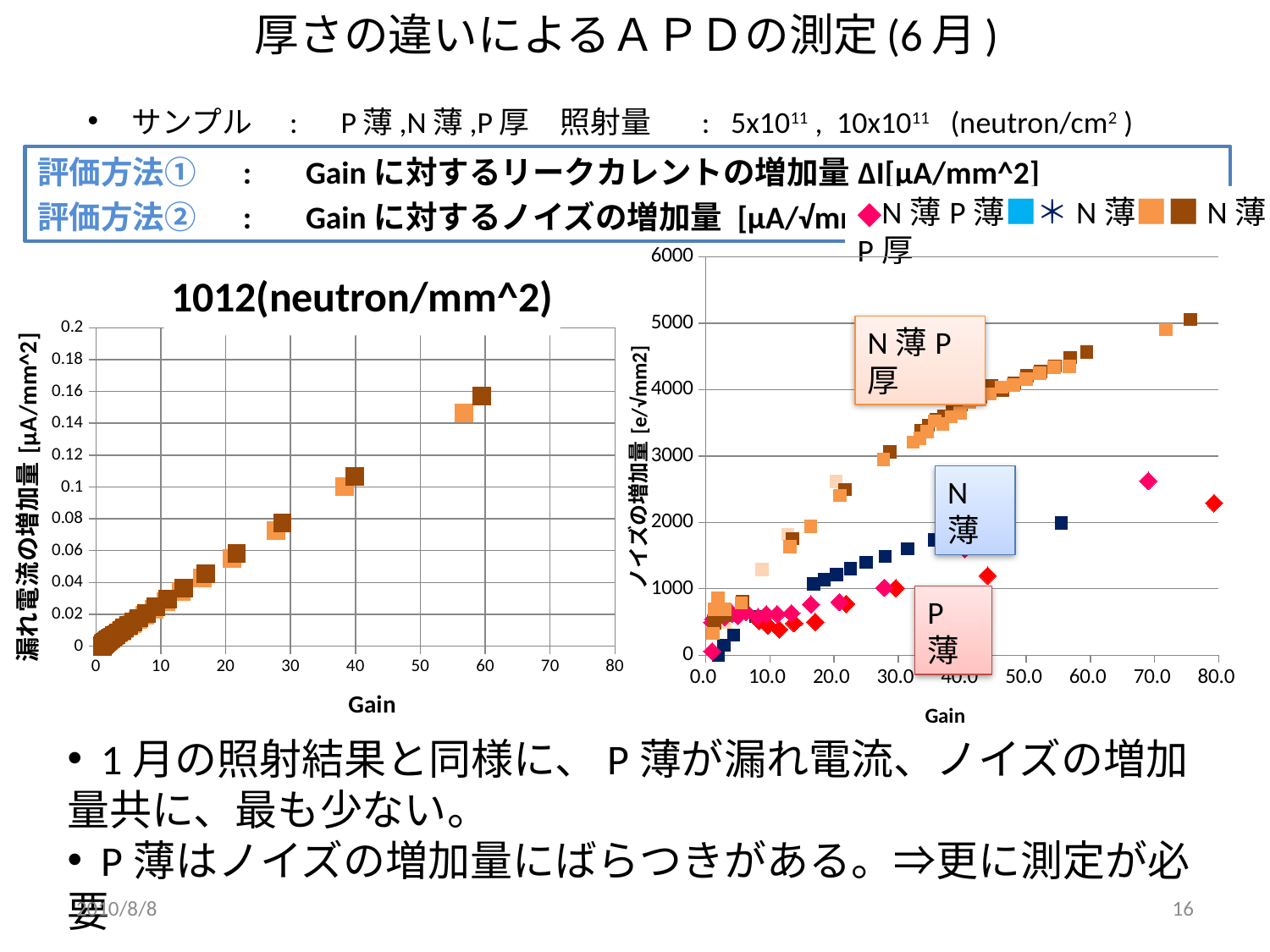
What kind of chart is the left chart titled 1012(neutron/mm^2)? scatter chart What kind of chart is the right chart showing ノイズの増加量 against Gain? scatter chart In the right chart, is the value of the N薄P薄 (pink diamond) series at a Gain of about 80 greater or less than 3000? less In the left chart titled 1012(neutron/mm^2), do the plotted values rise or fall as Gain increases? rise In the right chart, what is the label of the y axis? ノイズの増加量 [e/√mm2] In the right chart, do the values of the N薄P厚 series rise or fall as Gain increases? rise In the right chart, at a Gain of about 70, which series has the larger value: N薄P厚 or N薄P薄? N薄P厚 In the left chart titled 1012(neutron/mm^2), is the value plotted at a Gain of about 20 greater or less than 0.04? greater In the left chart titled 1012(neutron/mm^2), is the value plotted at a Gain of about 60 greater or less than 0.1? greater In the right chart, what is the maximum value shown on the y axis? 6000 In the left chart titled 1012(neutron/mm^2), what is the label of the x axis? Gain